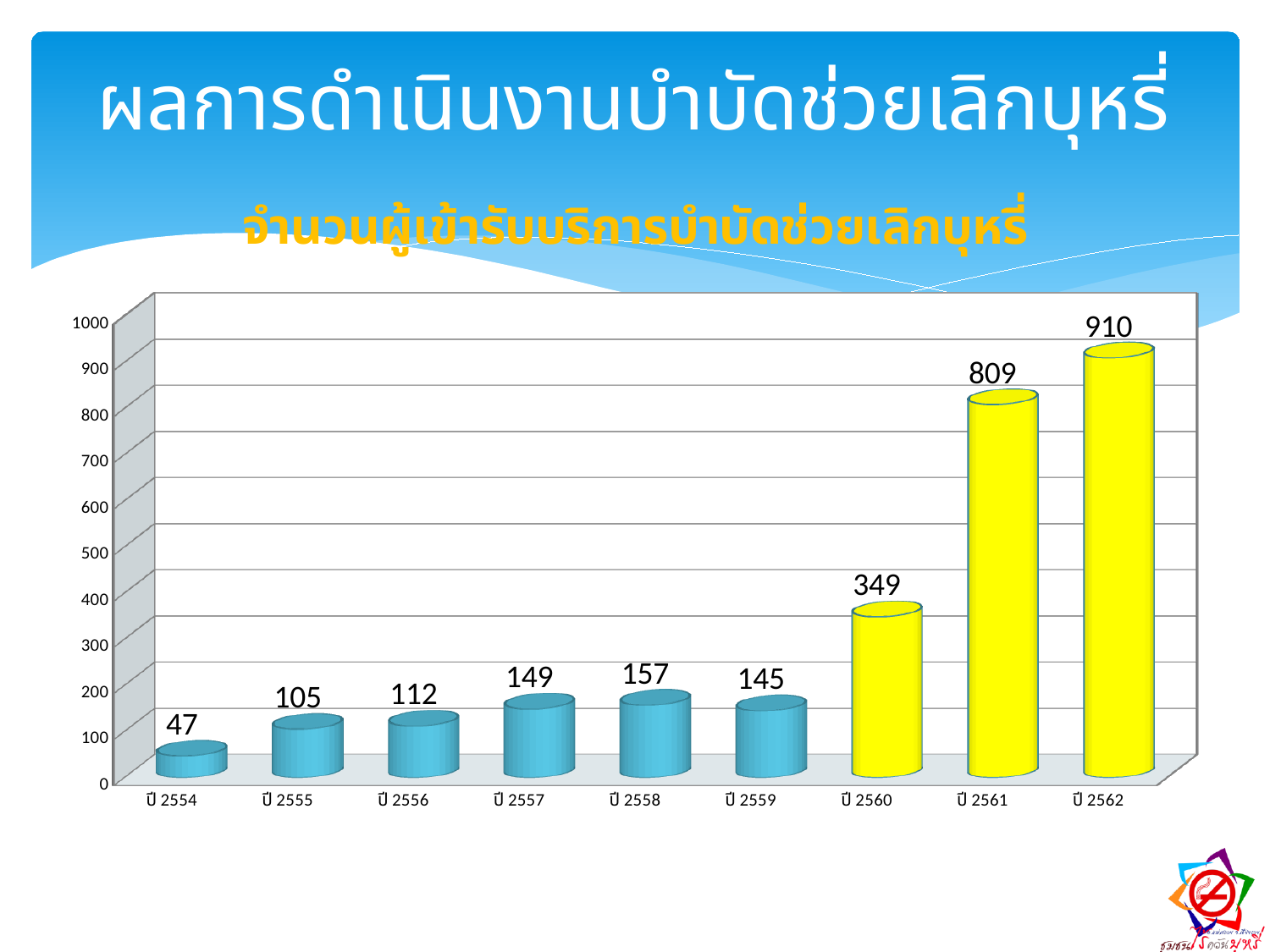
Which is larger, the value for ปี 2558 or the value for ปี 2559? ปี 2558 Which year has the highest value? ปี 2562 Is the value for ปี 2561 greater or less than 800? greater What is the value for ปี 2554? 47 What colour are the bars for ปี 2560 to ปี 2562? yellow What is the value for ปี 2558? 157 What is the value for ปี 2560? 349 What is the difference between the values for ปี 2562 and ปี 2561? 101 How many years (categories) are shown on the x axis? 9 What kind of chart is shown on the slide? bar chart Which year has the lowest value? ปี 2554 What is the difference between the values for ปี 2560 and ปี 2559? 204